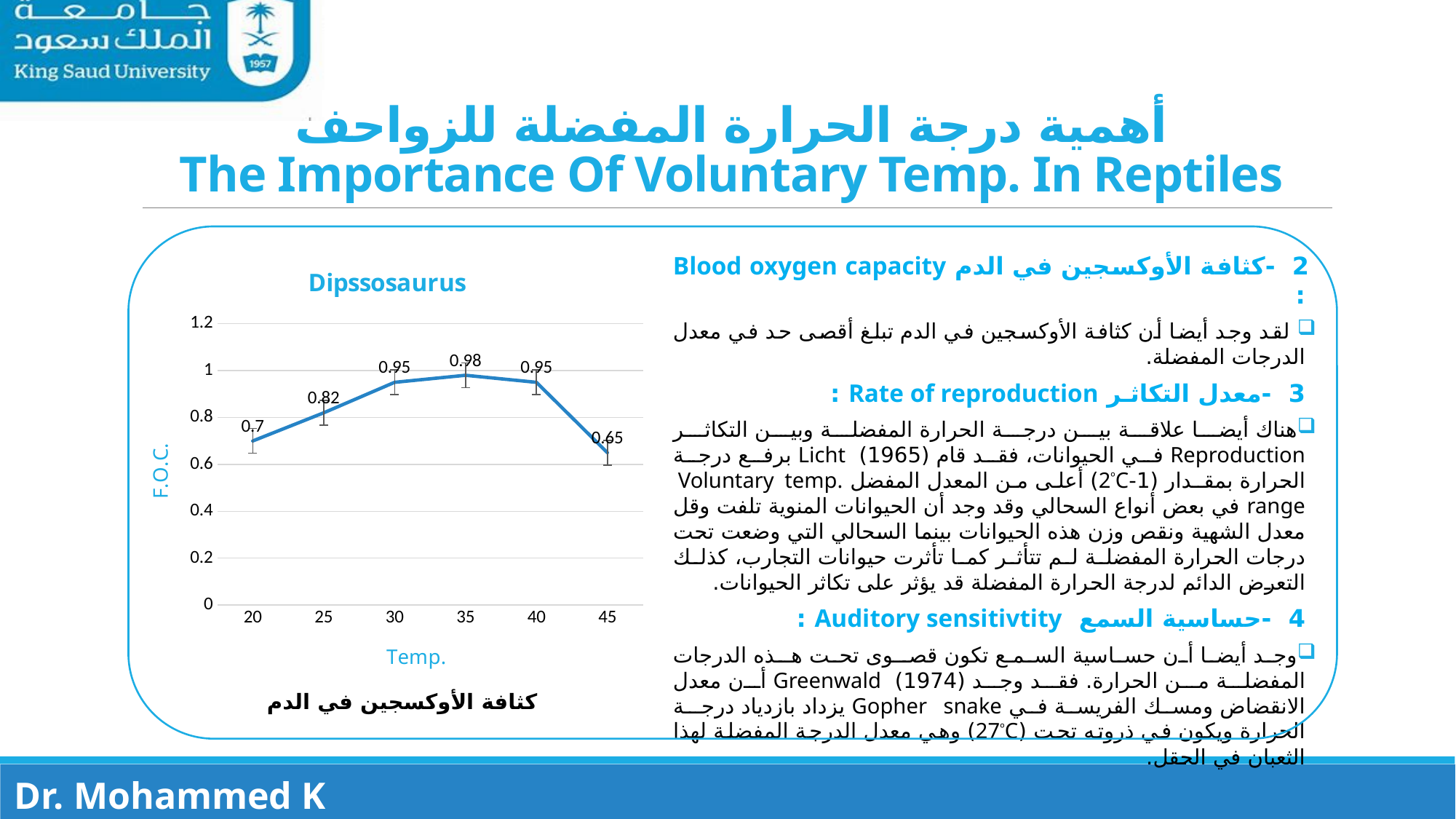
How many Temp. points are plotted in the Dipssosaurus chart? 6 What is the F.O.C. value at Temp. 20 in the Dipssosaurus chart? 0.7 At which Temp. is the F.O.C. value lowest in the Dipssosaurus chart? 45 What is the F.O.C. value at Temp. 25 in the Dipssosaurus chart? 0.82 At which Temp. is the F.O.C. value highest in the Dipssosaurus chart? 35 In the Dipssosaurus chart, does the F.O.C. value rise or fall from Temp. 40 to Temp. 45? Fall What is the difference between the F.O.C. values at Temp. 35 and Temp. 20 in the Dipssosaurus chart? 0.28 What kind of chart is the Dipssosaurus chart? Line chart Which has a larger F.O.C. value in the Dipssosaurus chart, Temp. 25 or Temp. 40? Temp. 40 What is the F.O.C. value at Temp. 35 in the Dipssosaurus chart? 0.98 What is the title of the chart on the slide? Dipssosaurus What is the F.O.C. value at Temp. 45 in the Dipssosaurus chart? 0.65